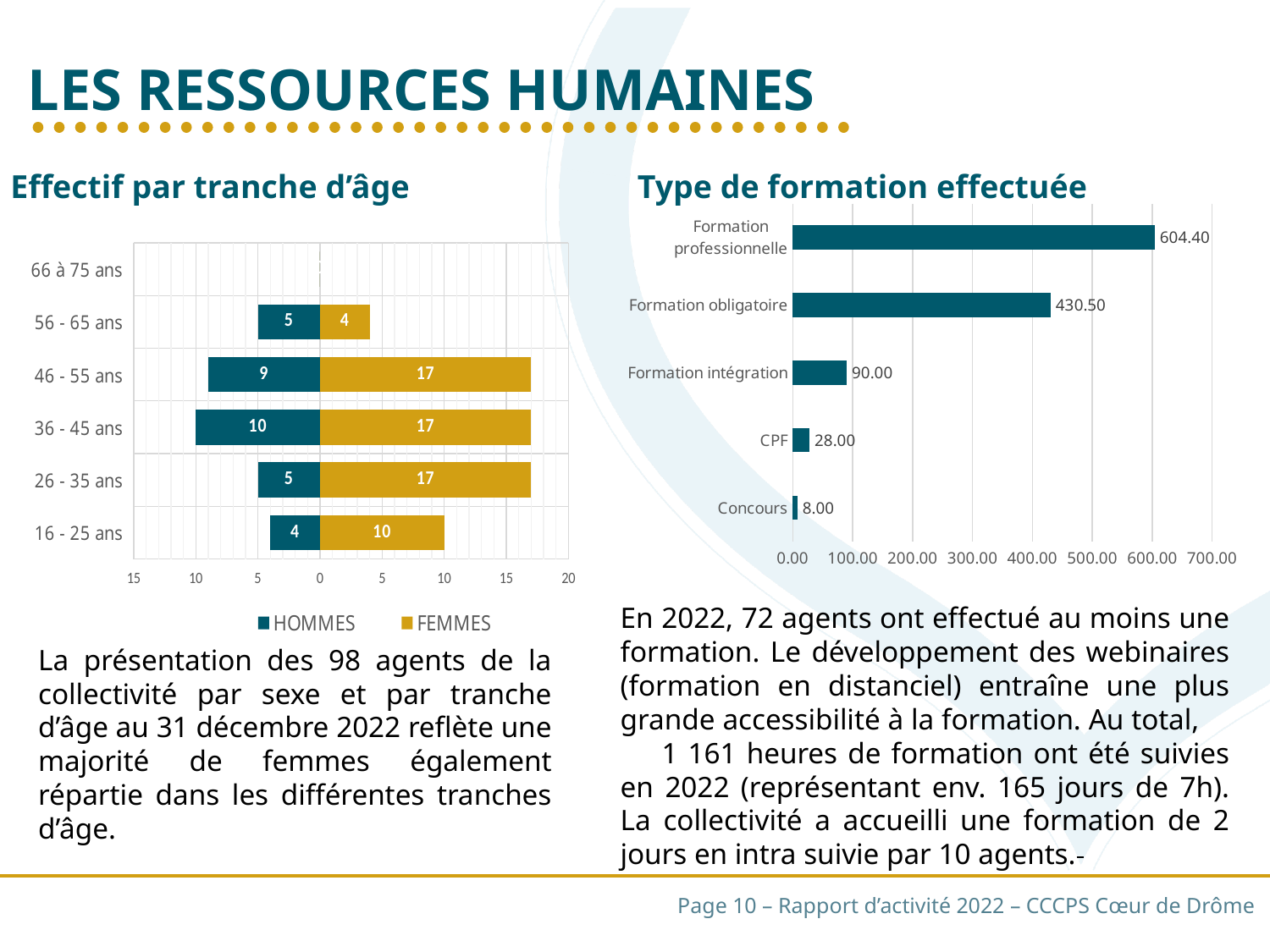
In the 'Type de formation effectuée' chart, which category has the lowest value? Concours In the 'Type de formation effectuée' chart, which category has the highest value? Formation professionnelle In the 'Type de formation effectuée' chart, what is the difference between Formation professionnelle and Formation obligatoire? 173.90 In the 'Effectif par tranche d'âge' chart, how many series does the legend list? 2 In the 'Type de formation effectuée' chart, what is the value for CPF? 28.00 In the 'Effectif par tranche d'âge' chart, what is the FEMMES value for the 16 - 25 ans age group? 10 In the 'Type de formation effectuée' chart, what is the value for Formation obligatoire? 430.50 In the 'Type de formation effectuée' chart, how many categories are shown? 5 In the 'Effectif par tranche d'âge' chart, which is larger for the 26 - 35 ans group, HOMMES or FEMMES? FEMMES In the 'Effectif par tranche d'âge' chart, what is the HOMMES value for the 36 - 45 ans age group? 10 What kind of chart is 'Type de formation effectuée'? Bar chart In the 'Effectif par tranche d'âge' chart, what is the difference between FEMMES and HOMMES for the 46 - 55 ans group? 8